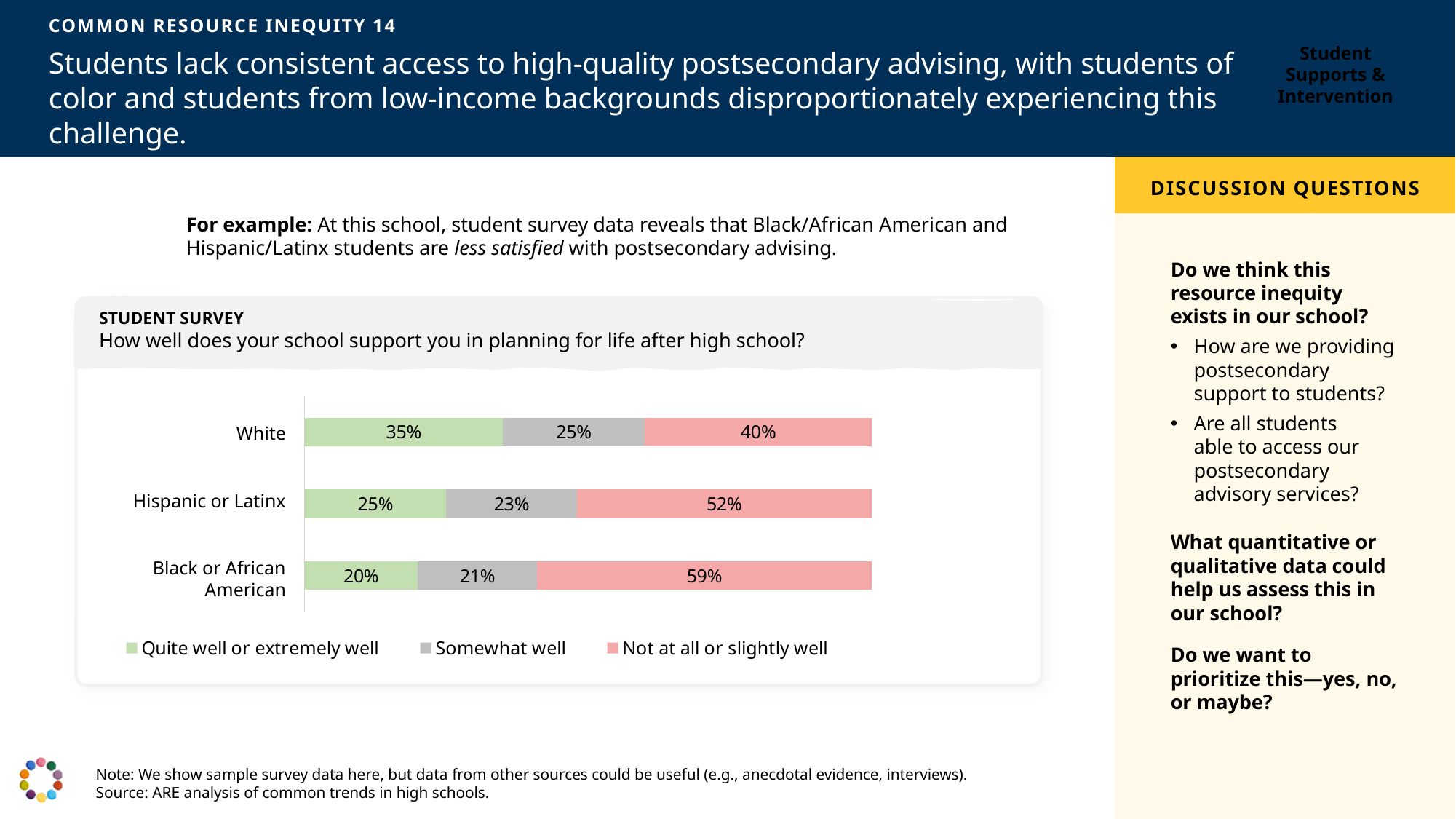
What kind of chart is shown on the slide? Stacked bar chart What percentage of White students answered "Not at all or slightly well"? 40% What is the difference between the "Not at all or slightly well" shares for Black or African American students and White students? 19 percentage points How many response categories does the legend list? 3 What survey question does the chart present? How well does your school support you in planning for life after high school? What percentage of Hispanic or Latinx students answered "Quite well or extremely well"? 25% How many student groups are shown in the chart? 3 Which is larger: the "Somewhat well" share for White students or for Hispanic or Latinx students? White What is the total of the three segments in the Hispanic or Latinx bar? 100% What percentage of Black or African American students answered "Somewhat well"? 21% Which group has the highest share answering "Not at all or slightly well"? Black or African American Which group has the lowest share answering "Quite well or extremely well"? Black or African American